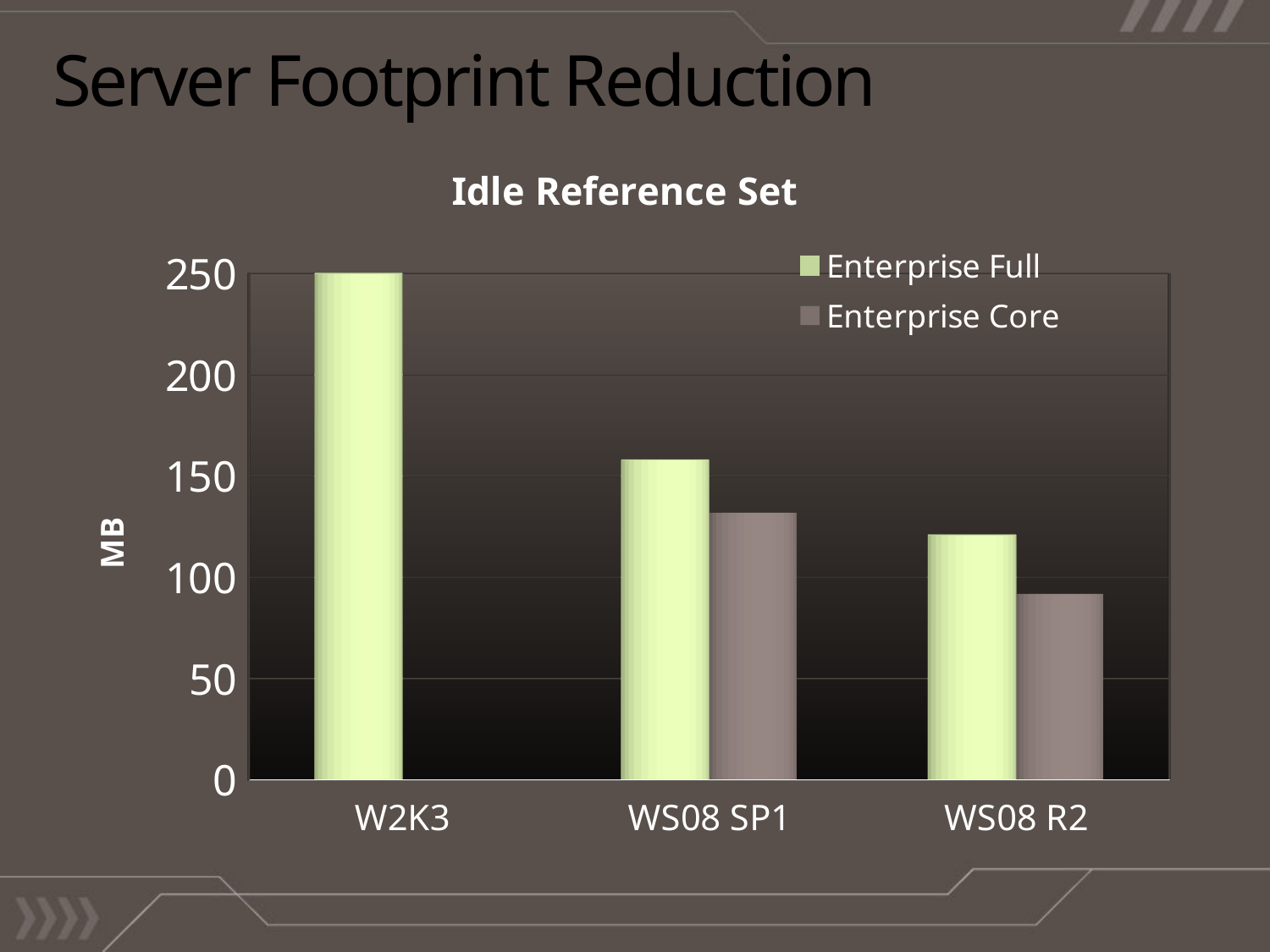
Which category has the lowest Enterprise Full value? WS08 R2 What kind of chart is shown on the slide? bar chart Which has the larger Enterprise Core value, WS08 SP1 or WS08 R2? WS08 SP1 What is the label on the vertical axis of the chart? MB Is the Enterprise Full value for WS08 SP1 greater or less than 150? greater Is the Enterprise Core value for WS08 SP1 greater or less than 100? greater How many series does the legend of the Idle Reference Set chart list? 2 Is the Enterprise Core value for WS08 R2 greater or less than 100? less What is the Enterprise Full value for W2K3? 250 How many categories are shown on the x axis of the Idle Reference Set chart? 3 Do the Enterprise Full values rise or fall from W2K3 to WS08 R2? fall Which category has the highest Enterprise Full value? W2K3